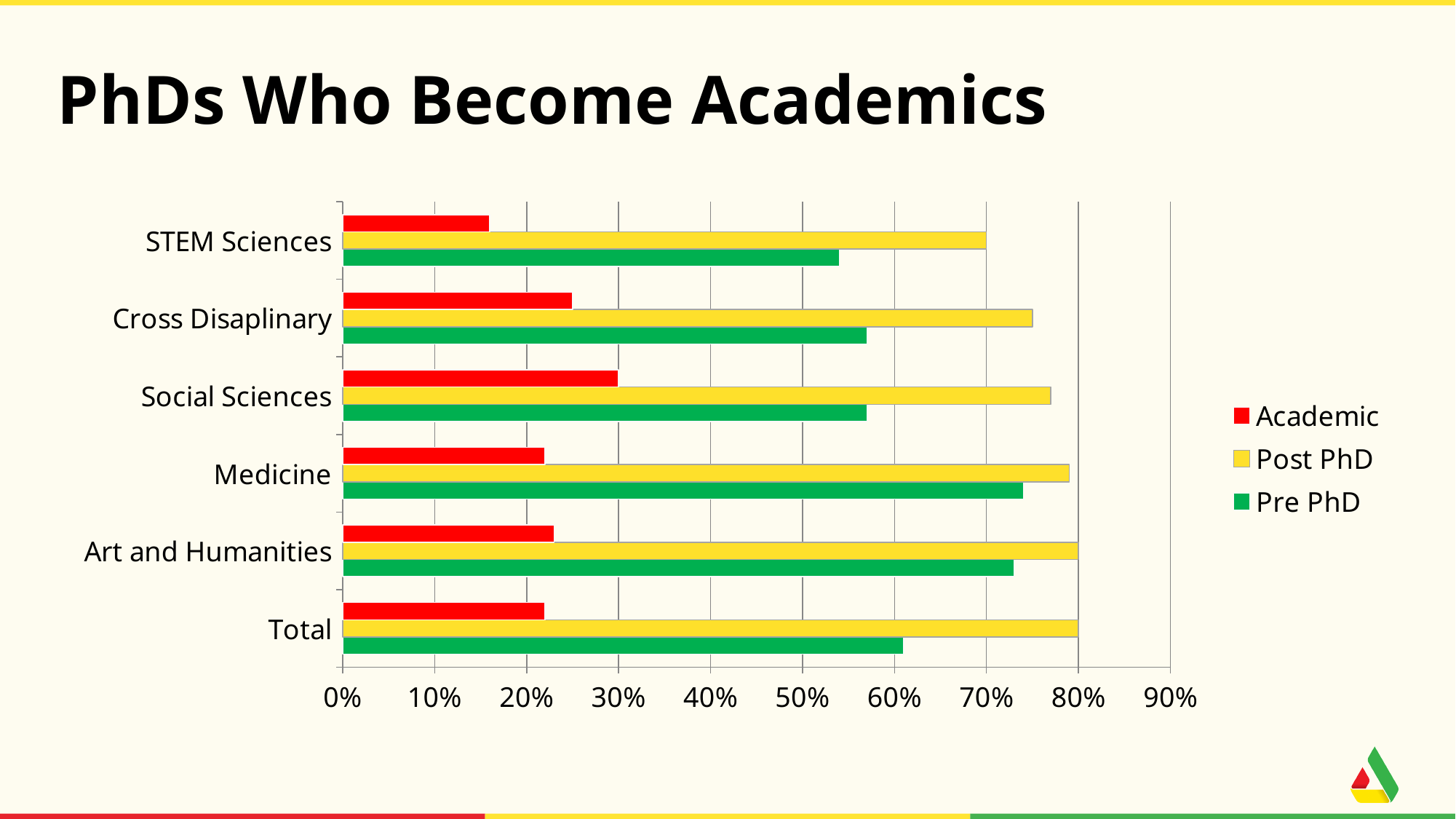
Which colour represents the Pre PhD series in the legend? green Is the Pre PhD value for Medicine greater or less than 70%? greater Is the Pre PhD value for Total greater or less than 70%? less Which is larger, the Pre PhD value for Medicine or the Pre PhD value for Cross Disaplinary? Medicine What is the title of the slide's chart? PhDs Who Become Academics Is the Post PhD value for Cross Disaplinary greater or less than 70%? greater Which category has the lowest Academic value? STEM Sciences Which category has the highest Academic value? Social Sciences How many categories are shown on the vertical axis? 6 What kind of chart is shown on the slide? bar chart How many series does the legend list? 3